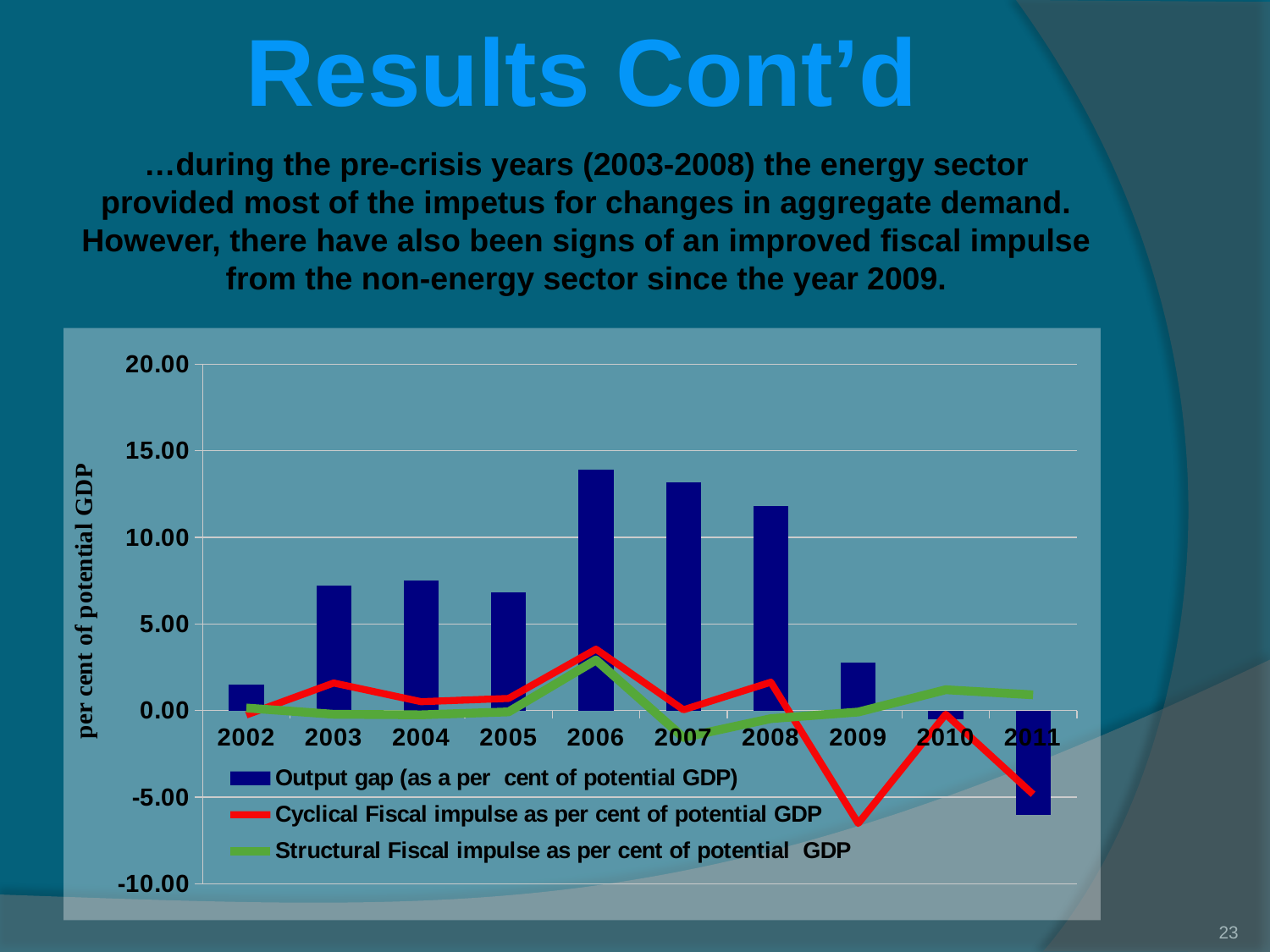
What is the label on the vertical axis of the chart? per cent of potential GDP Is the Output gap value for 2009 greater or less than 5.00? less What kind of chart is shown on the slide? Combined bar and line chart Which year has the larger Output gap, 2006 or 2008? 2006 In which year is the Output gap (as a per cent of potential GDP) highest? 2006 In which year is the Output gap (as a per cent of potential GDP) lowest? 2011 Is the Output gap value for 2006 greater or less than 10.00? greater Is the Cyclical Fiscal impulse value for 2009 greater or less than -5.00? less Does the Output gap rise or fall from 2006 to 2011? fall How many years are shown on the x axis of the chart? 10 How many series does the chart legend list? 3